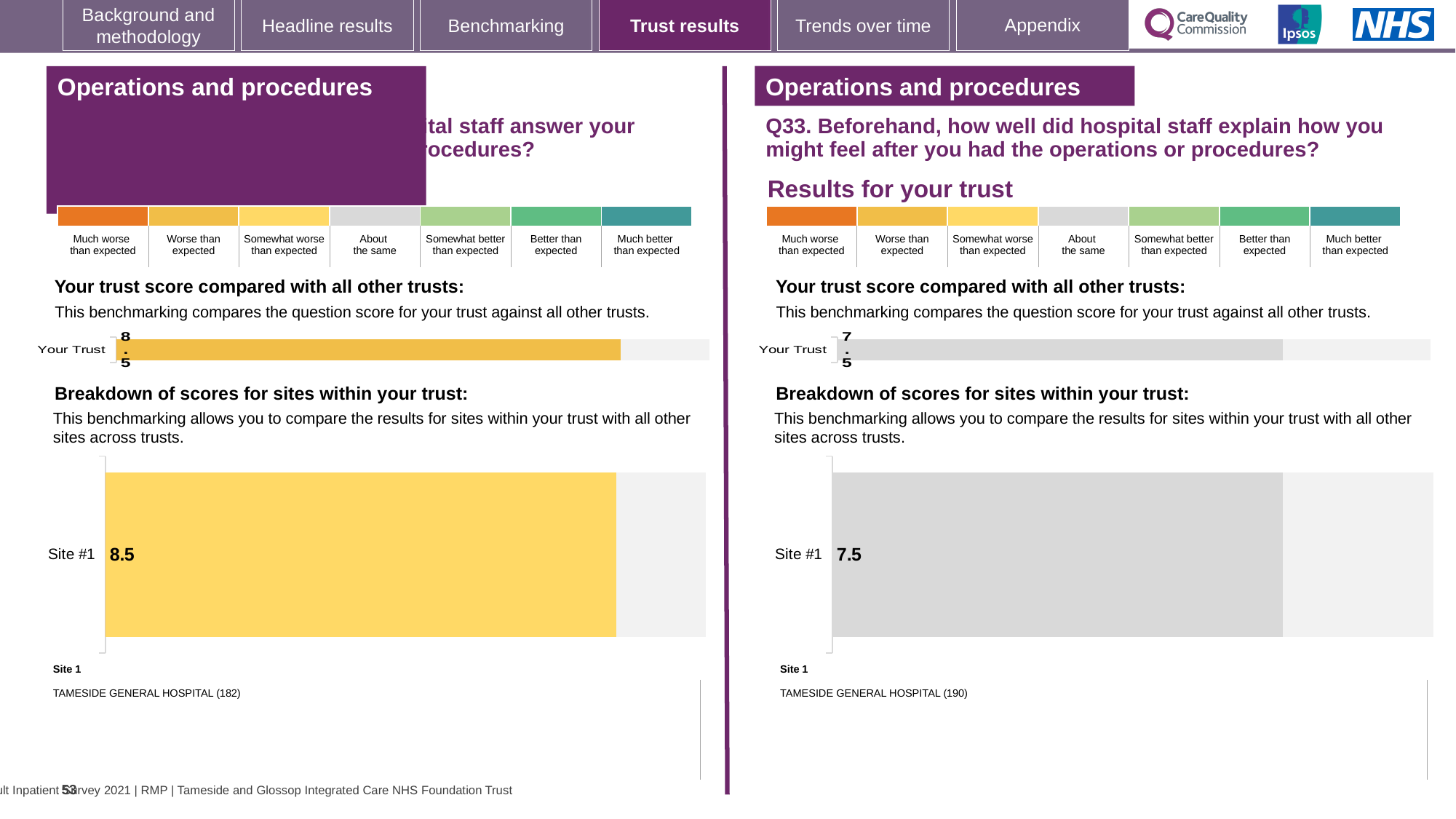
On the right panel (Q33), what is the score for Site #1 in the 'Breakdown of scores for sites within your trust' chart? 7.5 Which site name is listed under Site 1 on the right panel (Q33)? TAMESIDE GENERAL HOSPITAL (190) Which is larger: the Your Trust score on the left panel or the Your Trust score on the right panel (Q33)? Left panel (8.5) What type of chart is used to show the Site #1 score on the left panel? Bar chart Is the Site #1 score on the left panel greater or less than 8? greater What is the difference between the Site #1 score on the left panel and the Site #1 score on the right panel (Q33)? 1.0 On the left panel, what is the score shown for Your Trust in the 'Your trust score compared with all other trusts' chart? 8.5 On the left panel, what is the score for Site #1 in the 'Breakdown of scores for sites within your trust' chart? 8.5 Is the Your Trust score on the right panel (Q33) greater or less than 8? less How many sites are shown in the 'Breakdown of scores for sites within your trust' chart on the right panel (Q33)? 1 On the right panel (Q33), what is the score shown for Your Trust in the 'Your trust score compared with all other trusts' chart? 7.5 According to the colour key, which benchmark category does the grey Site #1 bar on the right panel (Q33) correspond to? About the same